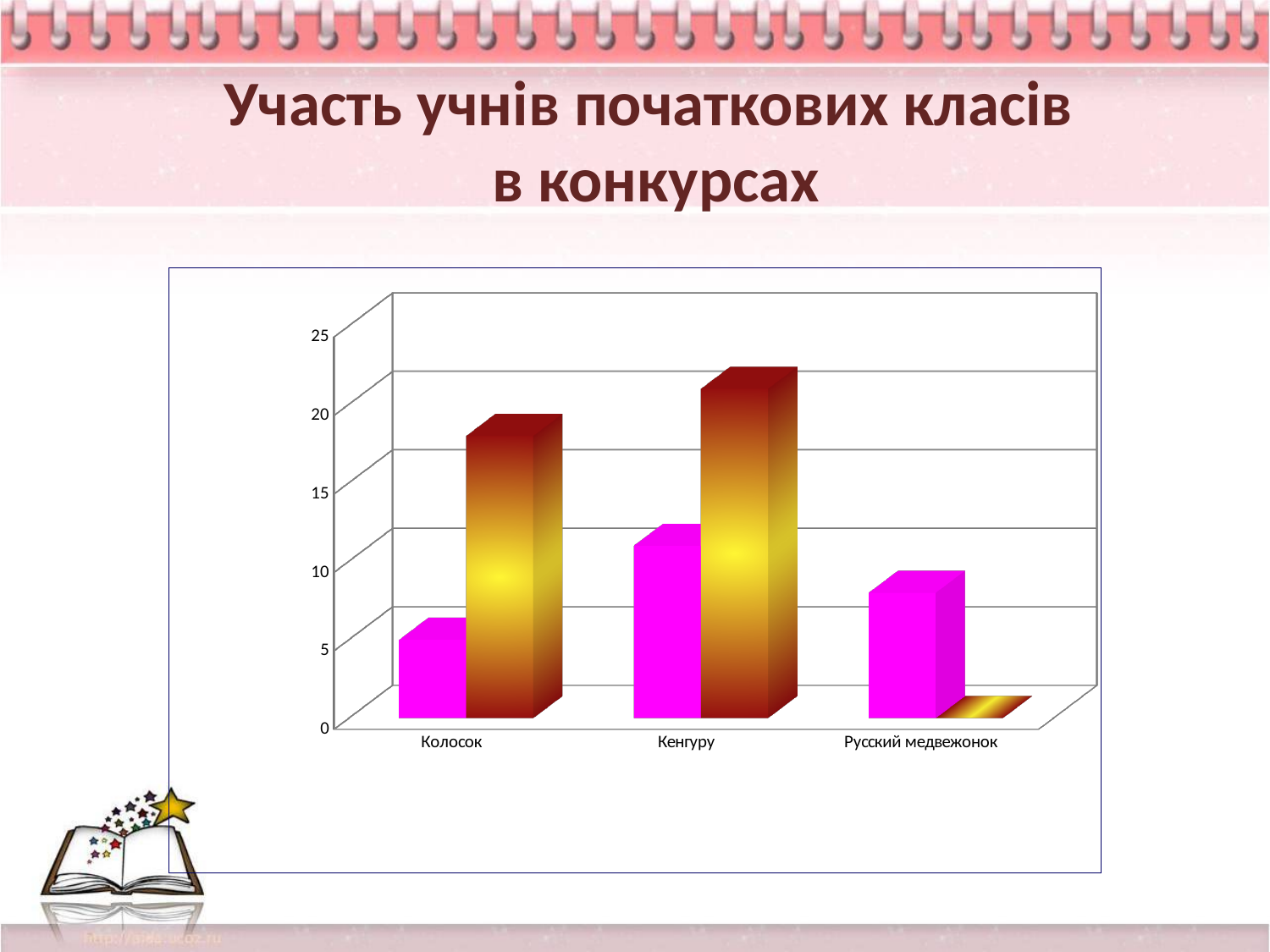
How many bars are shown for each category in the chart? 2 What is the title of the slide with the chart? Участь учнів початкових класів в конкурсах Which category has the tallest magenta bar? Кенгуру For Колосок, which bar is taller, the magenta one or the orange one? the orange one What kind of chart is shown on the slide? bar chart Which category has the shortest orange bar? Русский медвежонок For Русский медвежонок, which bar is taller, the magenta one or the orange one? the magenta one How many categories are shown on the x axis of the chart? 3 Is the value of the magenta bar for Колосок greater or less than 10? less Which category has the tallest orange bar? Кенгуру Is the value of the orange bar for Колосок greater or less than 15? greater Which category has the shortest magenta bar? Колосок